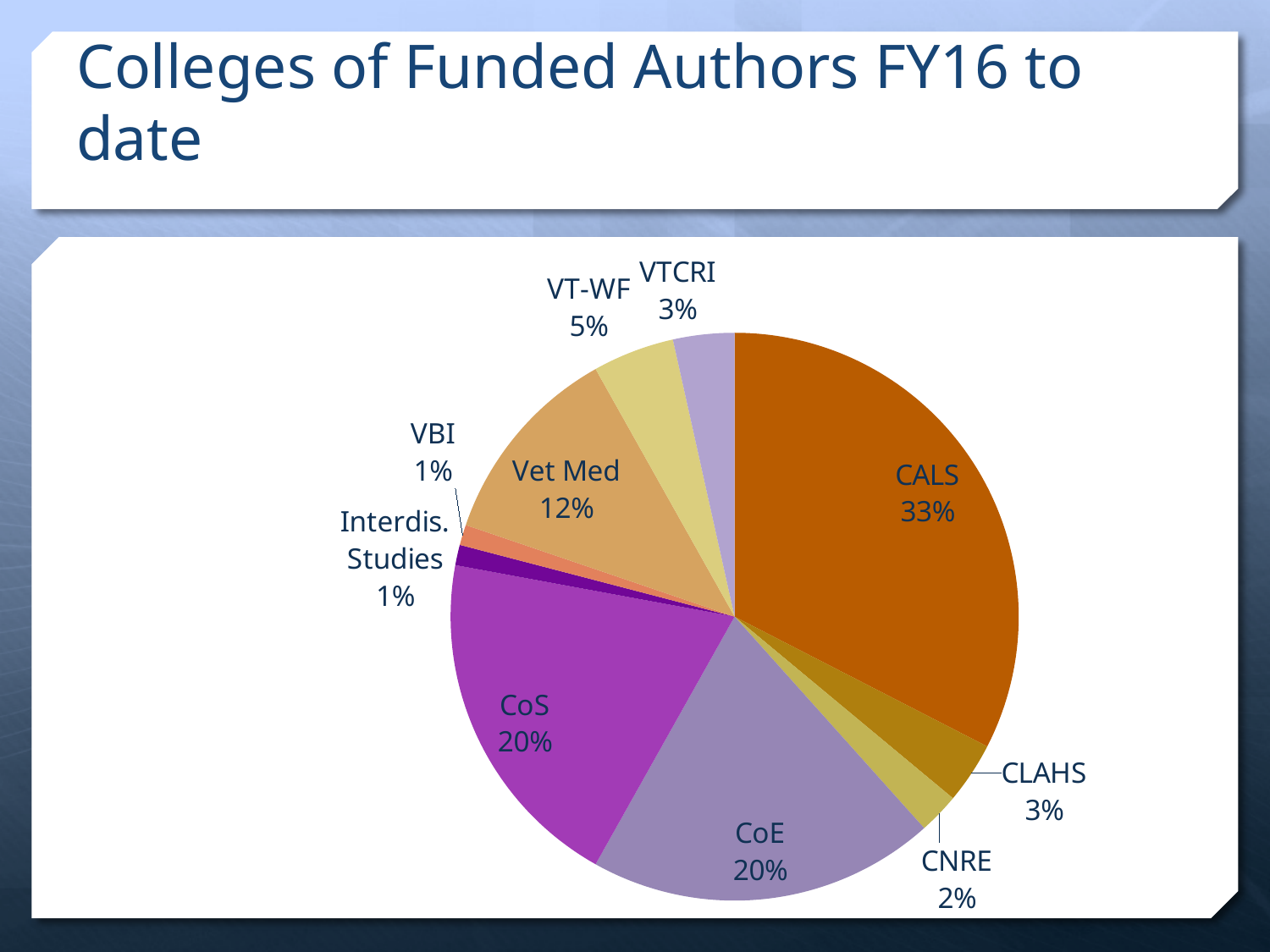
What is the title of the slide? Colleges of Funded Authors FY16 to date How many slices does the pie chart have? 10 Which is larger, the share for Vet Med or the share for VTCRI? Vet Med Which college has the largest slice of the pie? CALS What percentage is shown for CNRE? 2% What is the difference in percentage points between CALS and CoE? 13 What is the difference in percentage points between Vet Med and VT-WF? 7 What share of the pie does CALS hold? 33% What kind of chart is shown on the slide? Pie chart Which is larger, the share for CLAHS or the share for CNRE? CLAHS What percentage is shown for VT-WF? 5% What percentage is shown for Vet Med? 12%